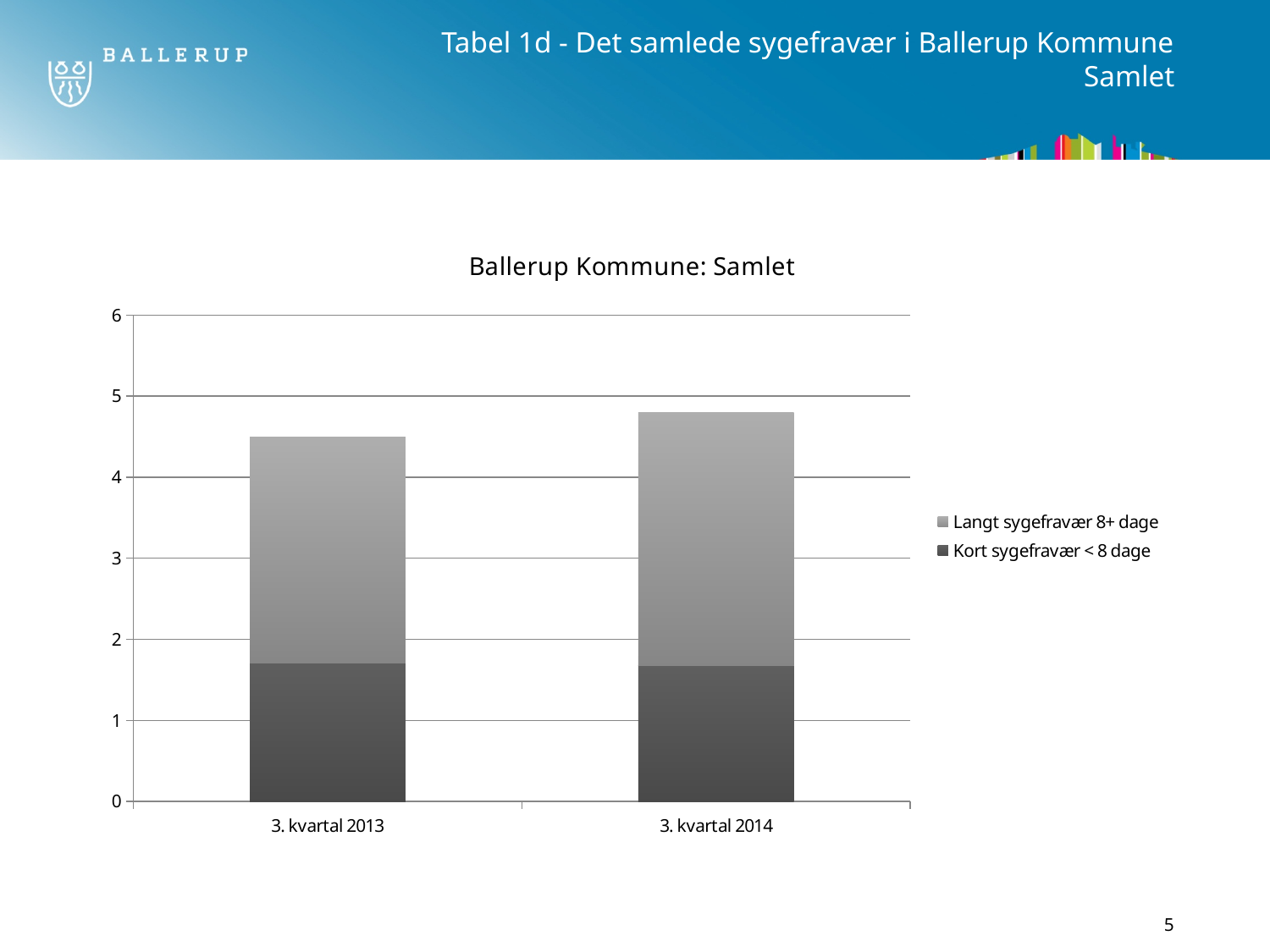
Is the total height of the bar for 3. kvartal 2013 greater or less than 4? greater What is the title of the chart? Ballerup Kommune: Samlet Does the total sygefravær rise or fall from 3. kvartal 2013 to 3. kvartal 2014? rise Which quarter has the larger Langt sygefravær 8+ dage segment? 3. kvartal 2014 Which quarter has the higher total bar, 3. kvartal 2013 or 3. kvartal 2014? 3. kvartal 2014 Is the total height of the bar for 3. kvartal 2014 greater or less than 5? less Which series is shown in the darker colour at the bottom of each bar? Kort sygefravær < 8 dage Is the value of Kort sygefravær < 8 dage for 3. kvartal 2014 greater or less than 1? greater What kind of chart is shown on the slide? Stacked bar chart How many categories are shown on the x axis of the chart? 2 How many series does the legend list? 2